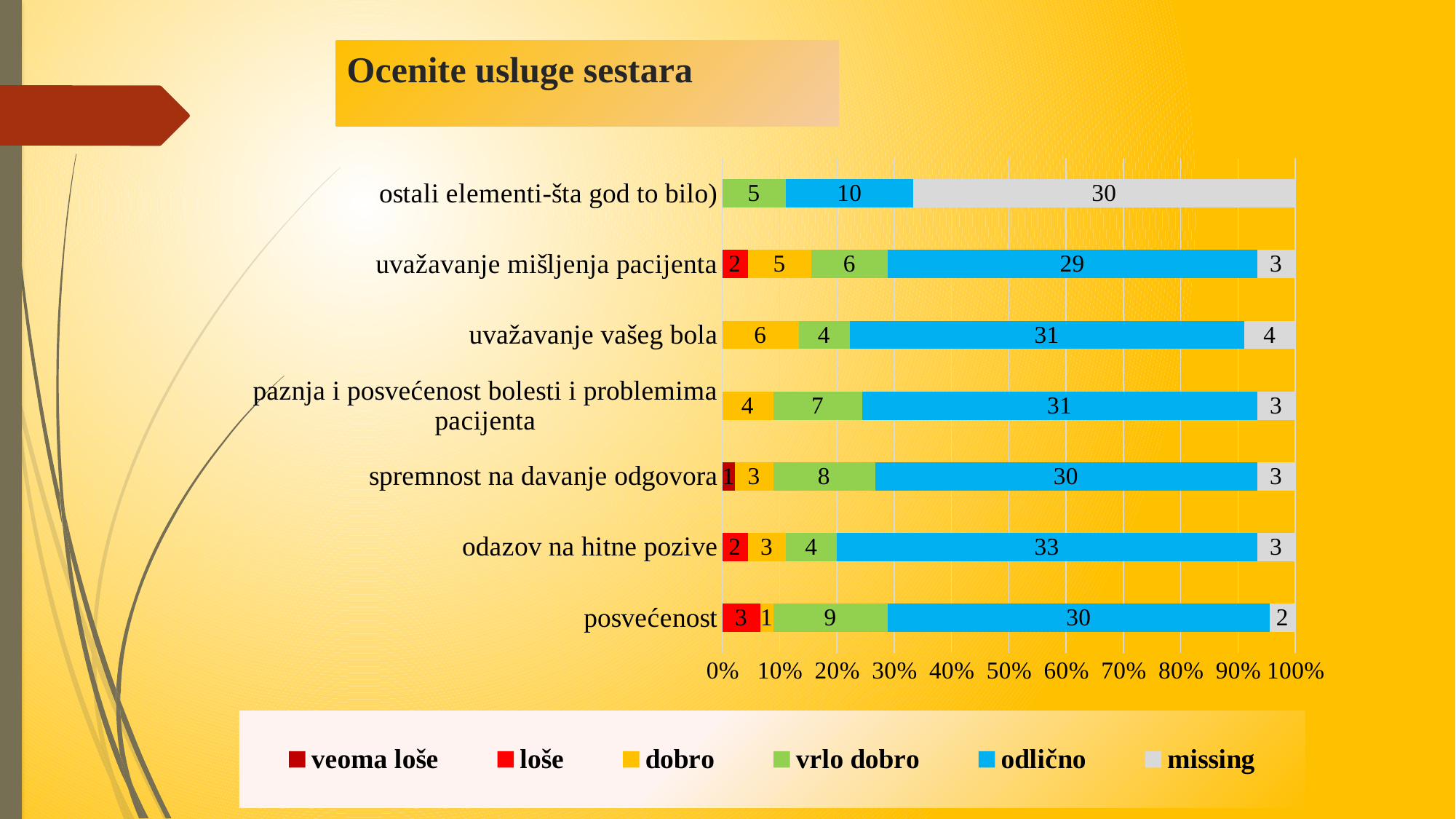
What type of chart is shown on the slide? stacked bar chart Which category has the lowest 'odlično' value? ostali elementi-šta god to bilo) How many series does the legend list? 6 Which is larger: the 'dobro' value for 'uvažavanje vašeg bola' or the 'dobro' value for 'paznja i posvećenost bolesti i problemima pacijenta'? uvažavanje vašeg bola What is the 'odlično' value for 'odazov na hitne pozive'? 33 What is the 'vrlo dobro' value for 'posvećenost'? 9 Which category has the highest 'odlično' value? odazov na hitne pozive What is the total of all segments in the 'posvećenost' bar? 45 What is the difference between the 'odlično' values for 'odazov na hitne pozive' and 'uvažavanje mišljenja pacijenta'? 4 What is the 'missing' value for 'ostali elementi-šta god to bilo)'? 30 How many categories are shown on the chart? 7 What is the title of the chart? Ocenite usluge sestara